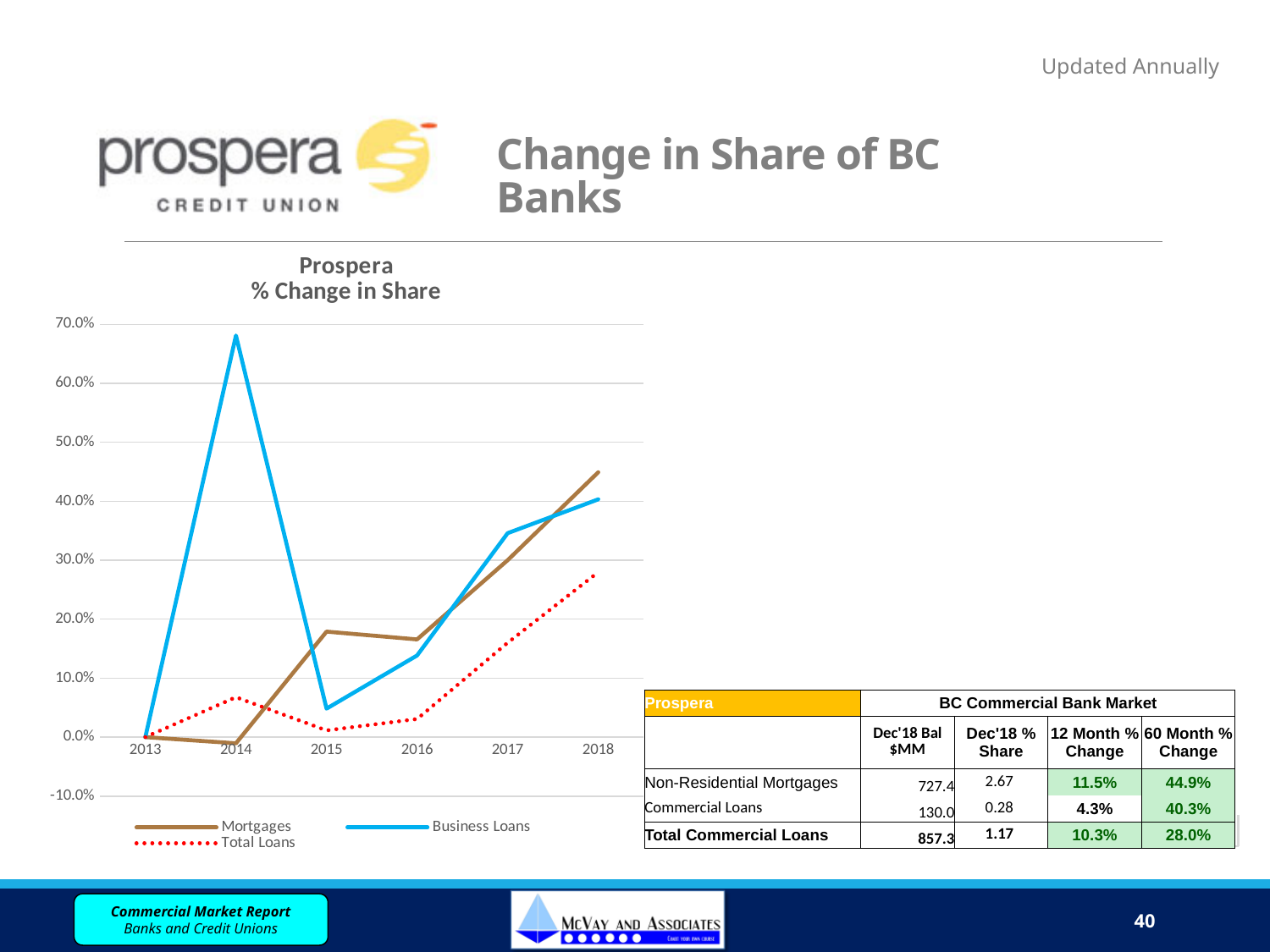
How many years are plotted along the x axis of the chart? 6 What kind of chart is shown on the slide? Line chart In which year does the Business Loans line reach its highest value? 2014 How many series does the chart legend list? 3 Is the value for Business Loans in 2014 greater or less than 60.0%? greater Which series in the chart is drawn with a dotted line? Total Loans Is the value for Business Loans in 2015 greater or less than 10.0%? less In which year does the Mortgages line reach its highest value? 2018 Does the Total Loans line rise or fall from 2016 to 2018? Rise Is the value for Total Loans in 2018 greater or less than 20.0%? greater In 2014, which series has the larger value: Mortgages or Business Loans? Business Loans